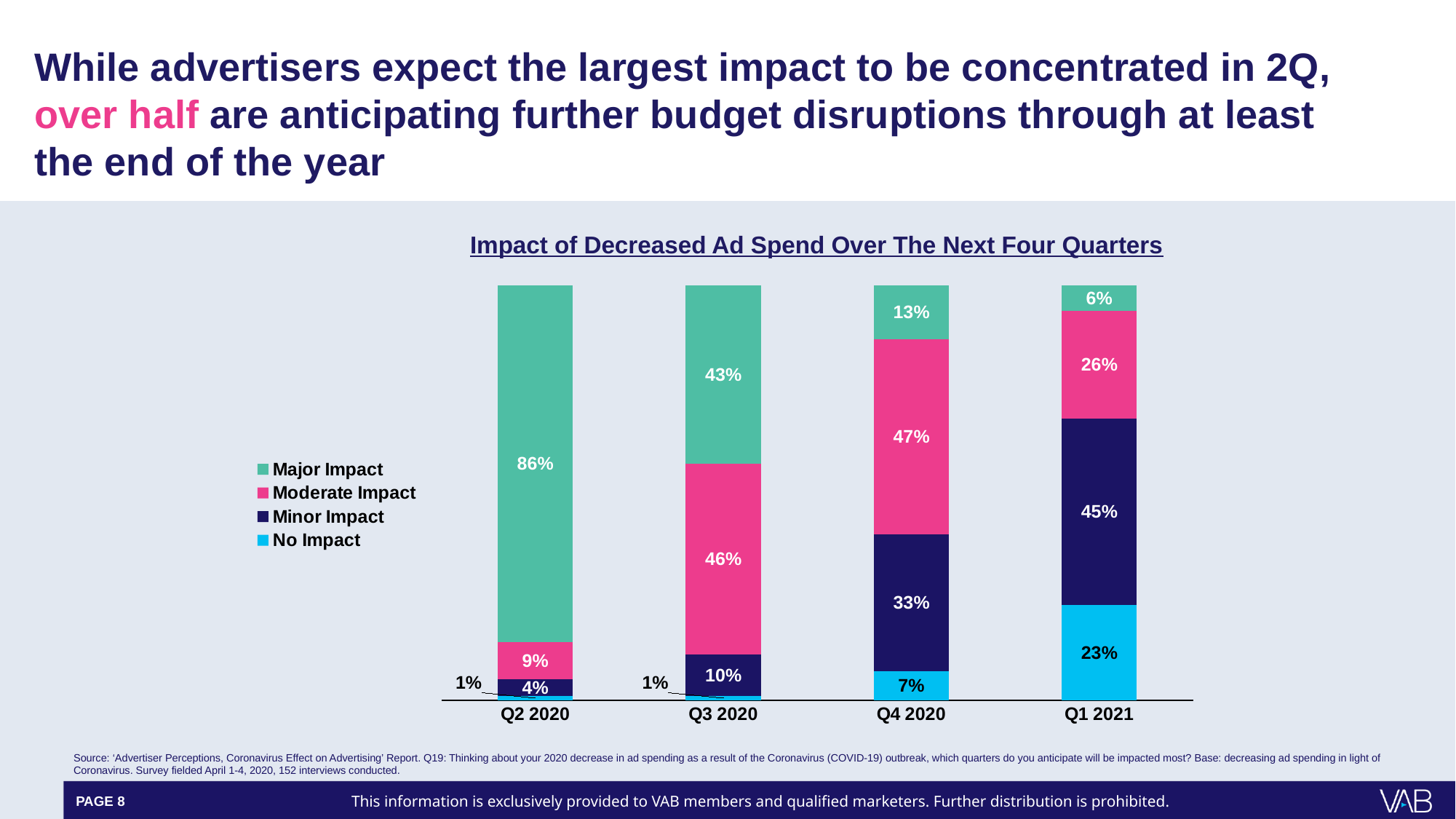
Which quarter has the lowest Minor Impact value? Q2 2020 What is the title of the chart? Impact of Decreased Ad Spend Over The Next Four Quarters What type of chart is shown on the slide? Stacked bar chart What is the No Impact value for Q1 2021? 23% How many series does the legend list? 4 How many quarters are shown on the x axis? 4 What is the difference between the Minor Impact values for Q1 2021 and Q4 2020? 12% Which quarter has the highest Major Impact value? Q2 2020 How does the Major Impact value change from Q2 2020 to Q1 2021? It falls What is the Major Impact value for Q2 2020? 86% Which is larger for Q3 2020: Major Impact or Moderate Impact? Moderate Impact What is the Moderate Impact value for Q4 2020? 47%